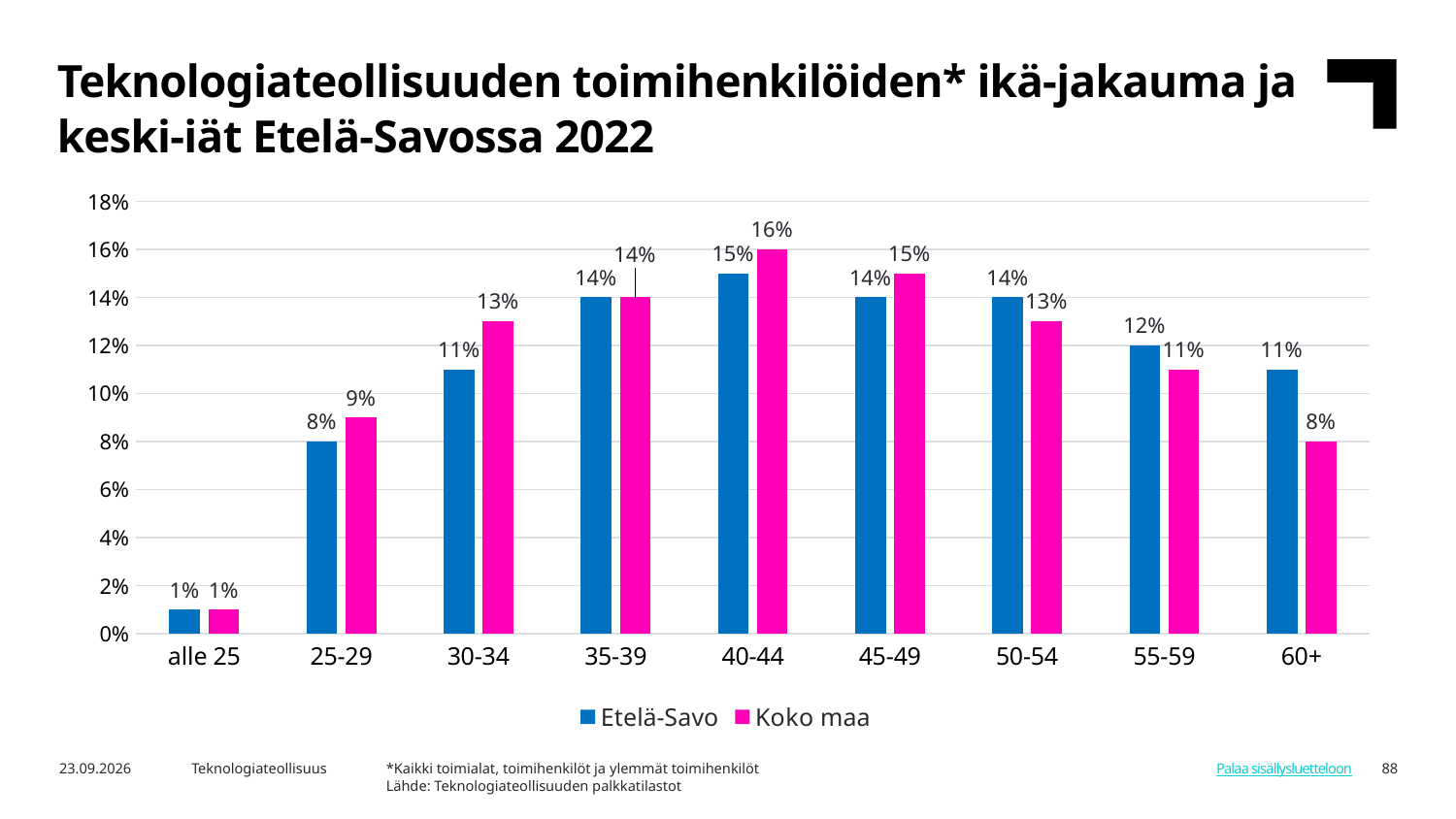
Which age group has the highest Koko maa value? 40-44 How many age groups are shown on the x axis? 9 For the 30-34 age group, which series has the larger value, Etelä-Savo or Koko maa? Koko maa What is the difference between the Koko maa and Etelä-Savo values for the 60+ age group? 3 percentage points What is the difference between the Etelä-Savo values for 40-44 and 25-29? 7 percentage points For the 55-59 age group, which series has the larger value, Etelä-Savo or Koko maa? Etelä-Savo What is the Koko maa value for the 30-34 age group? 13% What is the Etelä-Savo value for the 40-44 age group? 15% How many series does the legend list? 2 What kind of chart is shown on the slide? Bar chart What is the Koko maa value for the 60+ age group? 8% Which age group has the lowest Etelä-Savo value? alle 25